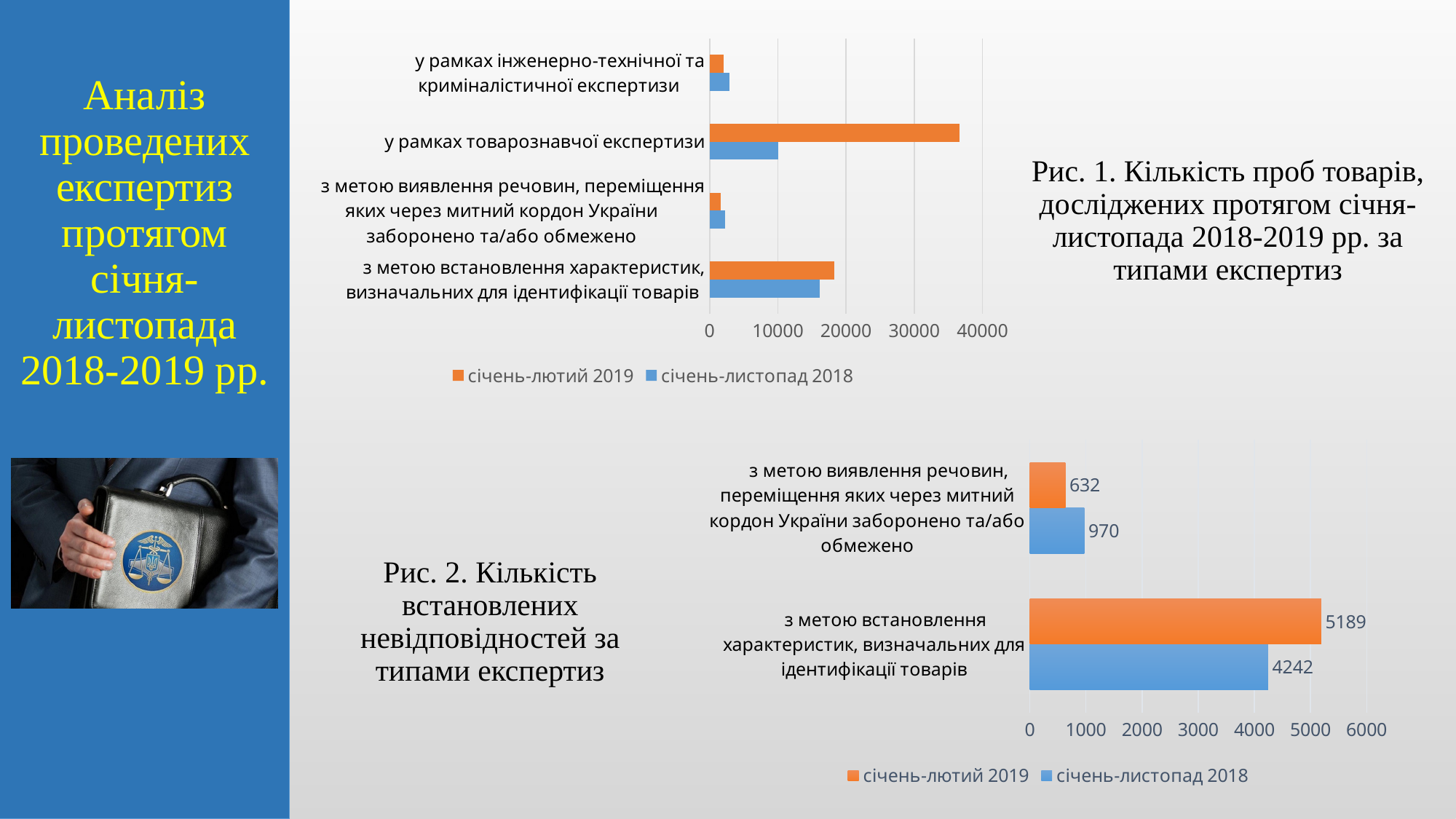
In the chart Рис. 2, what is the difference between the 'січень-лютий 2019' and 'січень-листопад 2018' values for 'з метою встановлення характеристик, визначальних для ідентифікації товарів'? 947 In the chart Рис. 2, which series has the larger value for 'з метою виявлення речовин, переміщення яких через митний кордон України заборонено та/або обмежено'? січень-листопад 2018 In the chart Рис. 2, what is the value for 'січень-лютий 2019' in the category 'з метою встановлення характеристик, визначальних для ідентифікації товарів'? 5189 In the chart Рис. 1, is the value for 'січень-листопад 2018' in 'у рамках товарознавчої експертизи' greater or less than 20000? less In the chart Рис. 1, how many series does the legend list? 2 In the chart Рис. 2, what is the value for 'січень-лютий 2019' in the category 'з метою виявлення речовин, переміщення яких через митний кордон України заборонено та/або обмежено'? 632 In the chart Рис. 2, what is the value for 'січень-листопад 2018' in the category 'з метою виявлення речовин, переміщення яких через митний кордон України заборонено та/або обмежено'? 970 In the chart Рис. 2, how many categories are shown? 2 In the chart Рис. 1, which category has the highest value for 'січень-лютий 2019'? у рамках товарознавчої експертизи What type of chart is Рис. 2? bar chart In the chart Рис. 1, is the value for 'січень-лютий 2019' in 'у рамках товарознавчої експертизи' greater or less than 30000? greater In the chart Рис. 1, how many categories are shown? 4